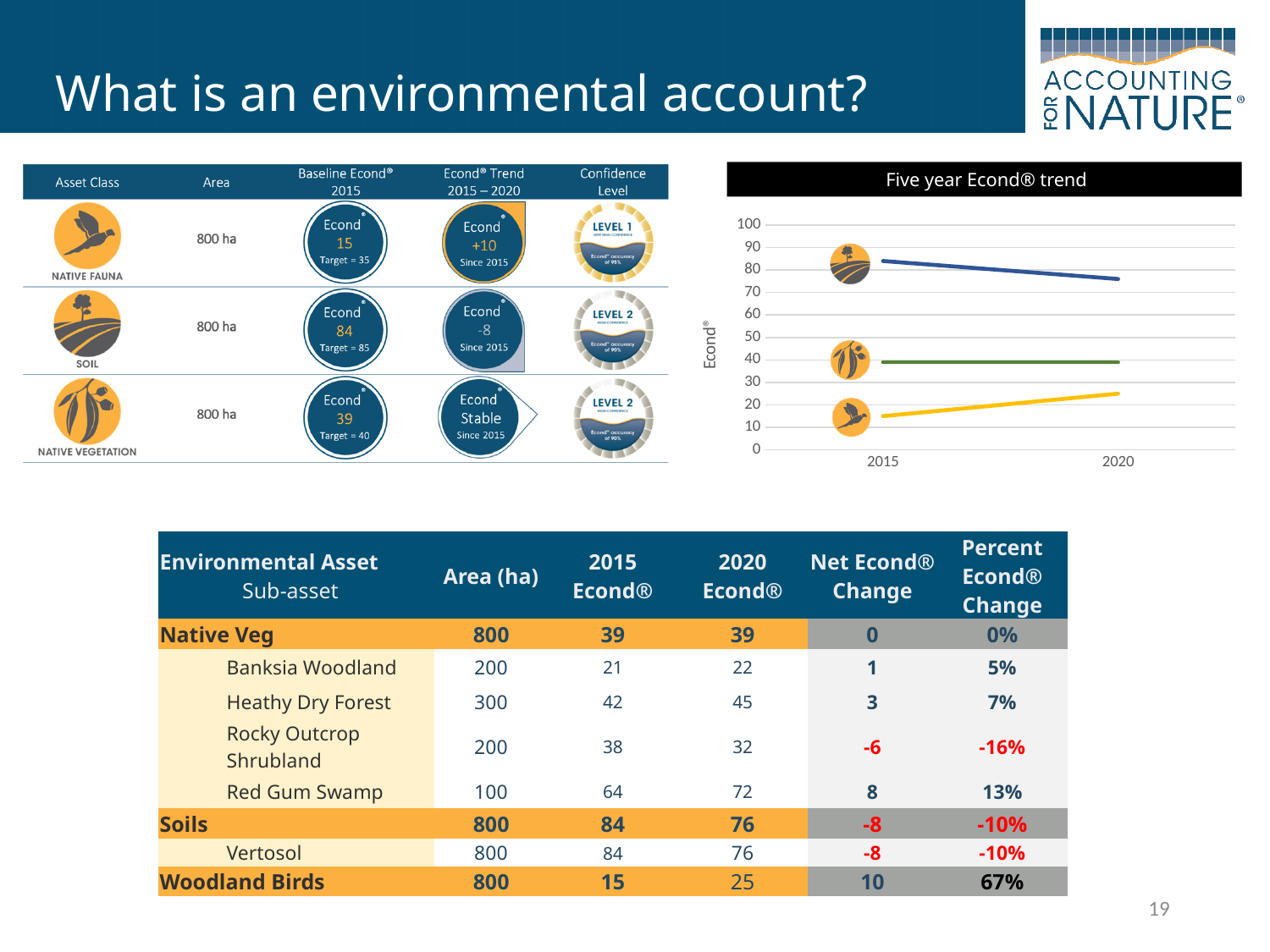
On the 'Five year Econd® trend' chart, is the blue line's value in 2020 greater or less than 80? less How many years are marked on the x axis of the 'Five year Econd® trend' chart? 2 What is the title of the chart on the right of the slide? Five year Econd® trend On the 'Five year Econd® trend' chart, does the yellow line rise or fall from 2015 to 2020? rise What kind of chart is the 'Five year Econd® trend' chart? line chart On the 'Five year Econd® trend' chart, is the blue line's value in 2015 greater or less than 80? greater How many lines are plotted on the 'Five year Econd® trend' chart? 3 On the 'Five year Econd® trend' chart, is the yellow line's value in 2015 greater or less than 20? less On the 'Five year Econd® trend' chart, which line has the highest value in 2020? the blue line What is the label on the y axis of the 'Five year Econd® trend' chart? Econd® On the 'Five year Econd® trend' chart, does the blue line rise or fall from 2015 to 2020? fall